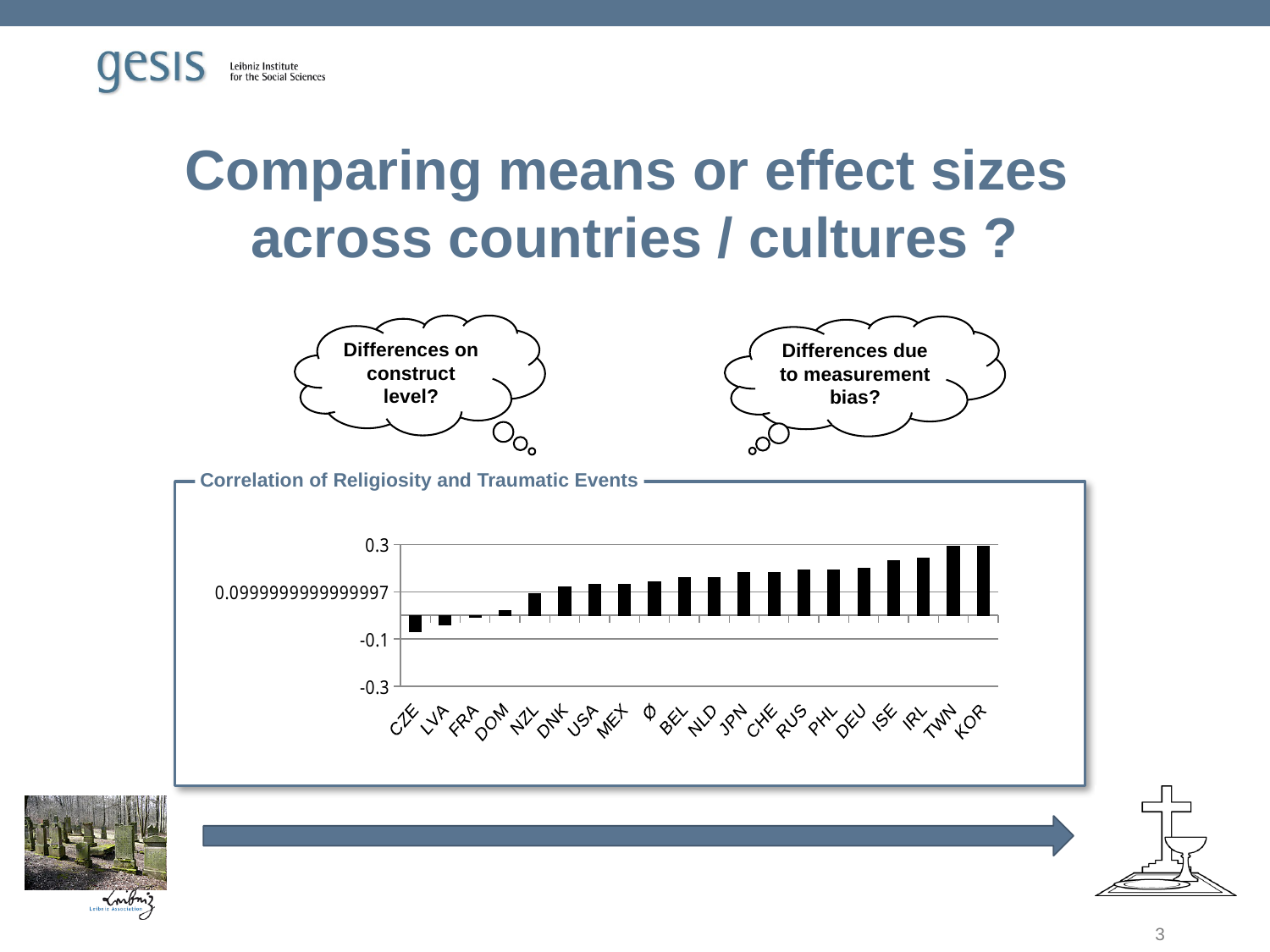
Which has the larger value, DEU or NZL? DEU Do the values generally rise or fall from left to right along the x axis? rise Which has the larger value, LVA or ISE? ISE Is the value for KOR greater or less than 0.1? greater Is the value for DOM greater or less than 0.1? less How many categories are shown on the x axis of the chart? 20 Is the value for CZE greater or less than 0.1? less What kind of chart is shown on the slide? bar chart Which has the larger value, KOR or CZE? KOR Which category has the lowest value in the chart? CZE What is the title of the chart on the slide? Correlation of Religiosity and Traumatic Events